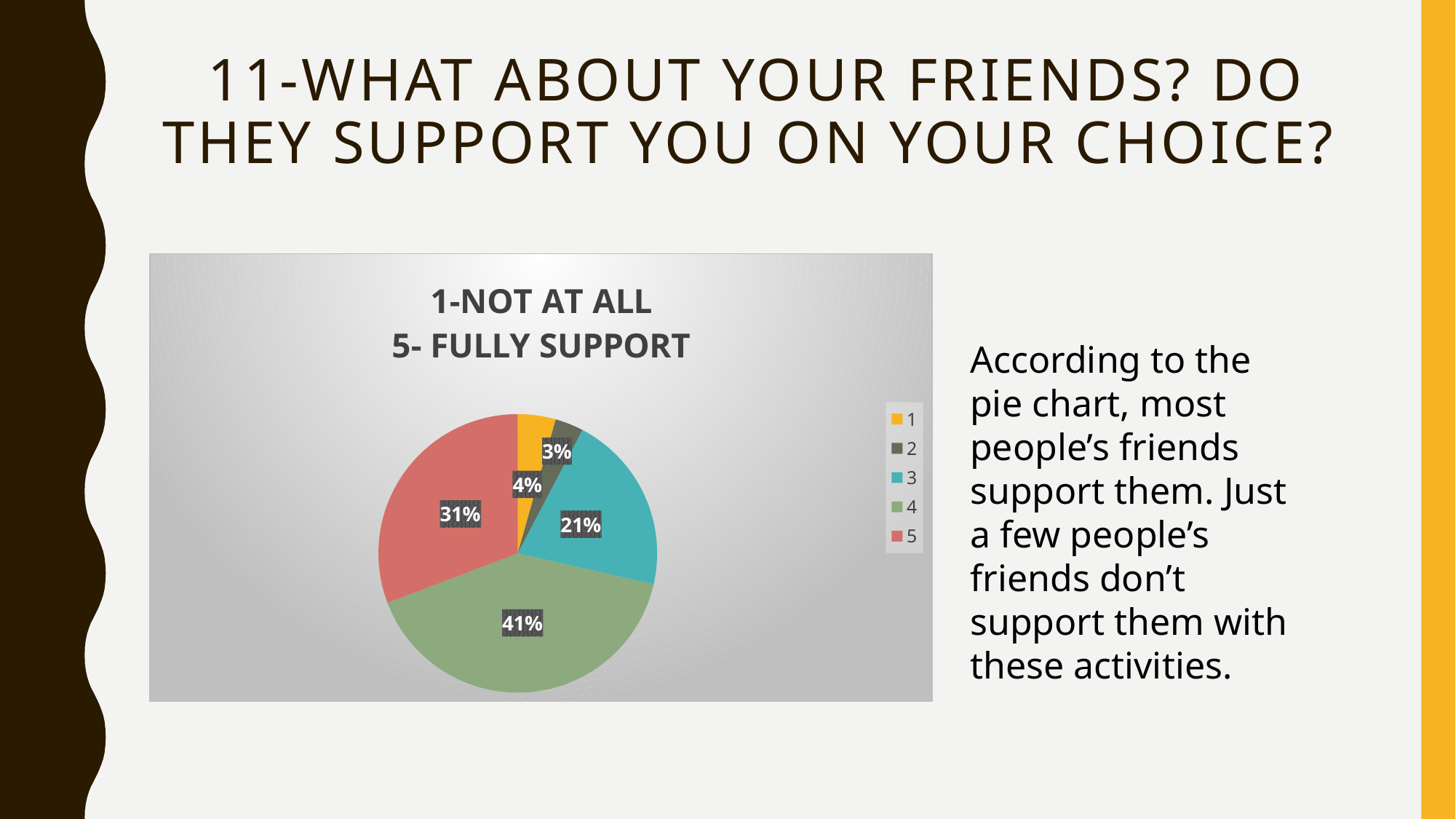
What percentage of the pie chart is category 2? 3% What is the difference in percentage points between category 4 and category 5? 10 What percentage of the pie chart is category 3? 21% Which category has the smallest share of the pie chart? 2 What colour is the slice for category 4 in the pie chart? green What type of chart is shown on the slide? pie chart What percentage of the pie chart is category 5? 31% How many categories does the legend of the pie chart list? 5 Which category has the largest share of the pie chart? 4 What percentage of the pie chart is category 1? 4% What percentage of the pie chart is category 4? 41% Which is larger, the share for category 3 or the share for category 5? 5